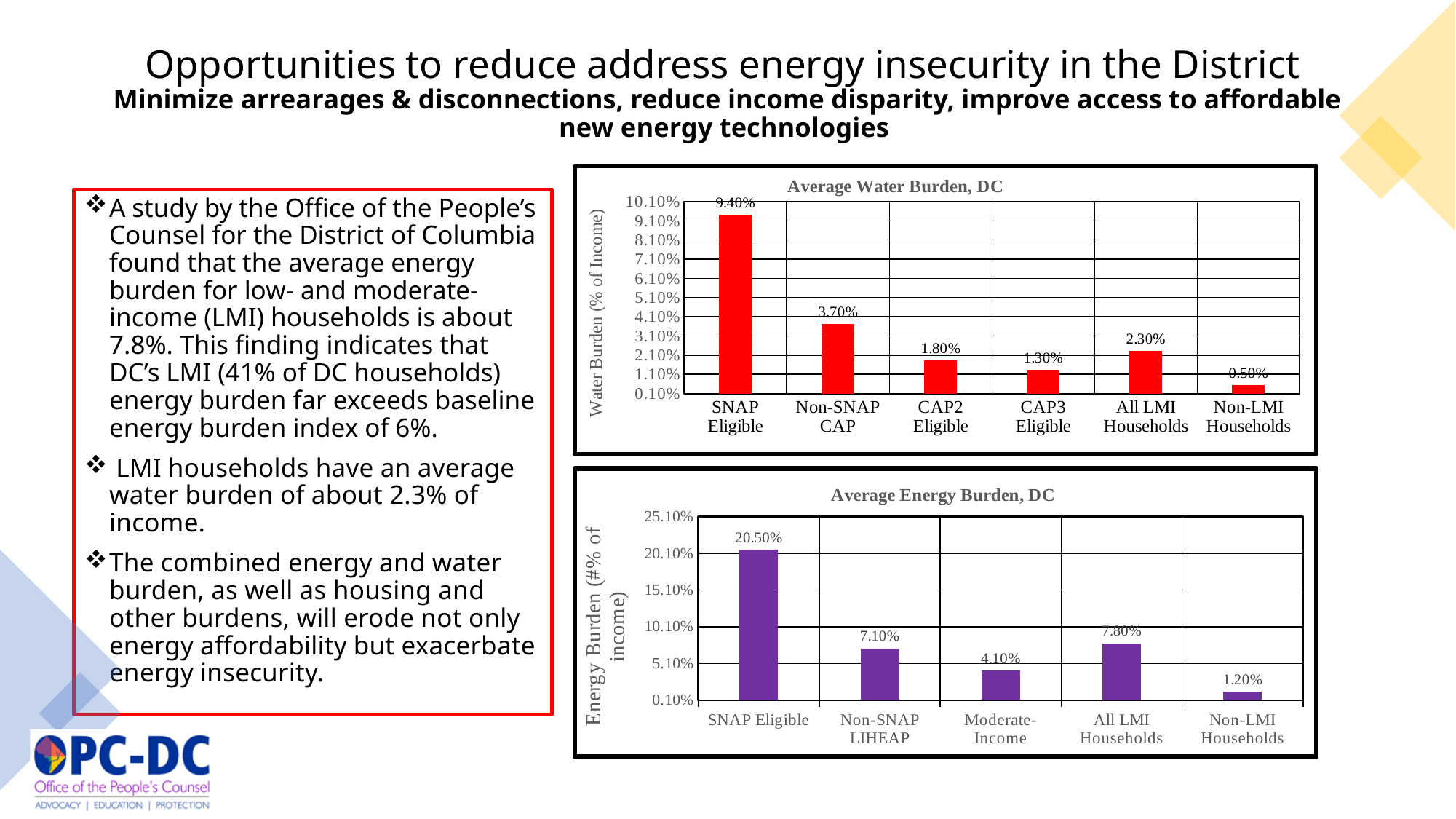
In the 'Average Water Burden, DC' chart, what is the difference between Non-SNAP CAP and CAP2 Eligible? 1.90% In the 'Average Water Burden, DC' chart, how many categories are shown? 6 In the 'Average Energy Burden, DC' chart, what is the value for Non-SNAP LIHEAP? 7.10% In the 'Average Water Burden, DC' chart, which is larger, CAP2 Eligible or CAP3 Eligible? CAP2 Eligible In the 'Average Water Burden, DC' chart, what is the value for All LMI Households? 2.30% What colour are the bars in the 'Average Water Burden, DC' chart? Red In the 'Average Energy Burden, DC' chart, what is the difference between SNAP Eligible and All LMI Households? 12.70% In the 'Average Energy Burden, DC' chart, which category has the highest energy burden? SNAP Eligible In the 'Average Energy Burden, DC' chart, how many categories are shown? 5 In the 'Average Water Burden, DC' chart, what is the value for SNAP Eligible? 9.40% What type of chart is the 'Average Energy Burden, DC' chart? Bar chart In the 'Average Water Burden, DC' chart, which category has the lowest water burden? Non-LMI Households